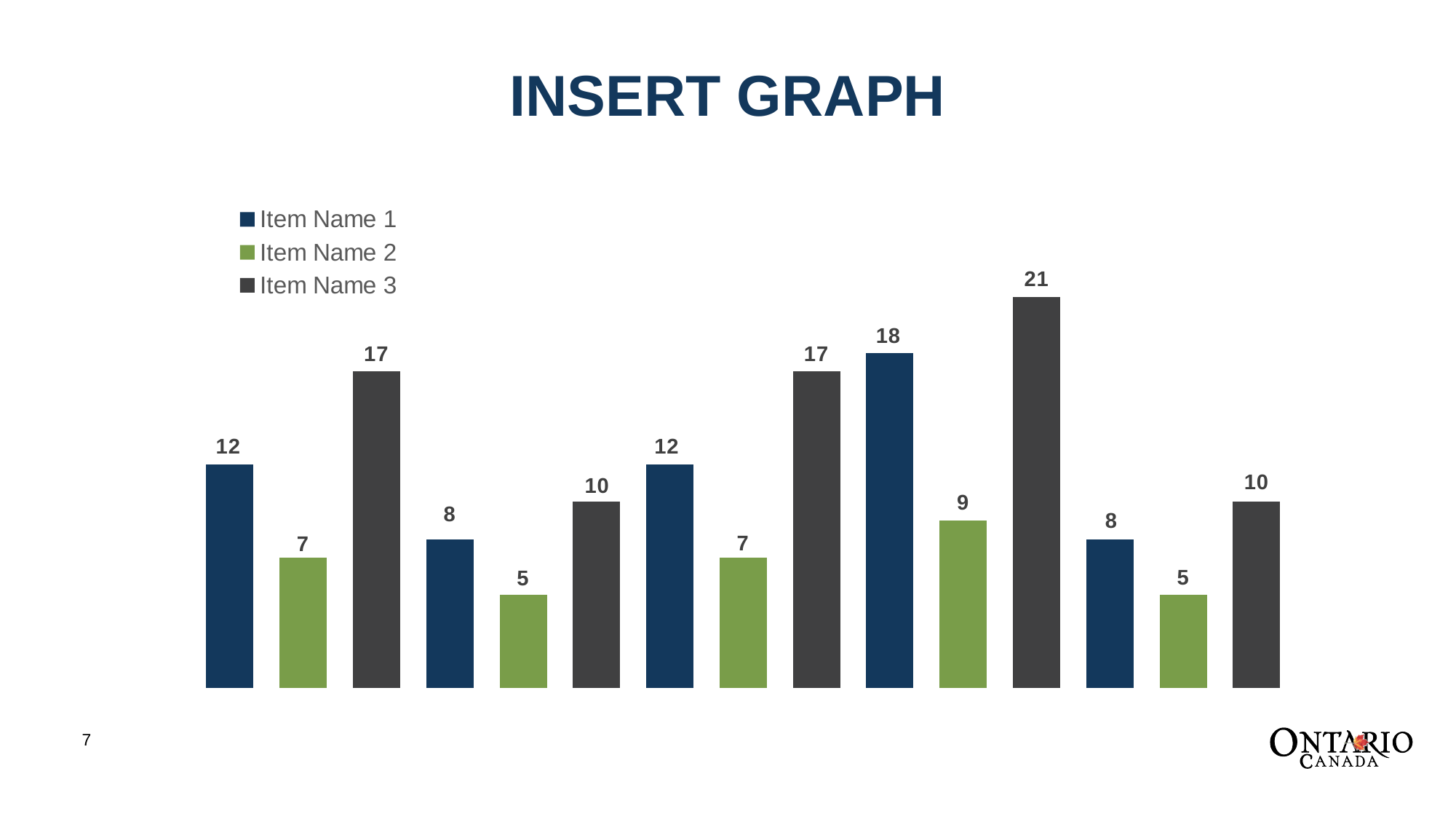
In the fourth group from the left, what is the difference between the Item Name 3 bar and the Item Name 1 bar? 3 How many groups of bars are plotted along the x axis? 5 What is the value of the Item Name 1 bar in the first group from the left? 12 What is the value of the Item Name 2 bar in the second group from the left? 5 In the first group from the left, which is larger: the Item Name 1 bar or the Item Name 2 bar? Item Name 1 What is the title of the slide? INSERT GRAPH What is the lowest value shown on the chart? 5 Which series has the tallest bar in every group? Item Name 3 What is the highest value shown on the chart? 21 What kind of chart is shown on the slide? bar chart What is the value of the Item Name 3 bar in the fourth group from the left? 21 How many series does the legend list? 3